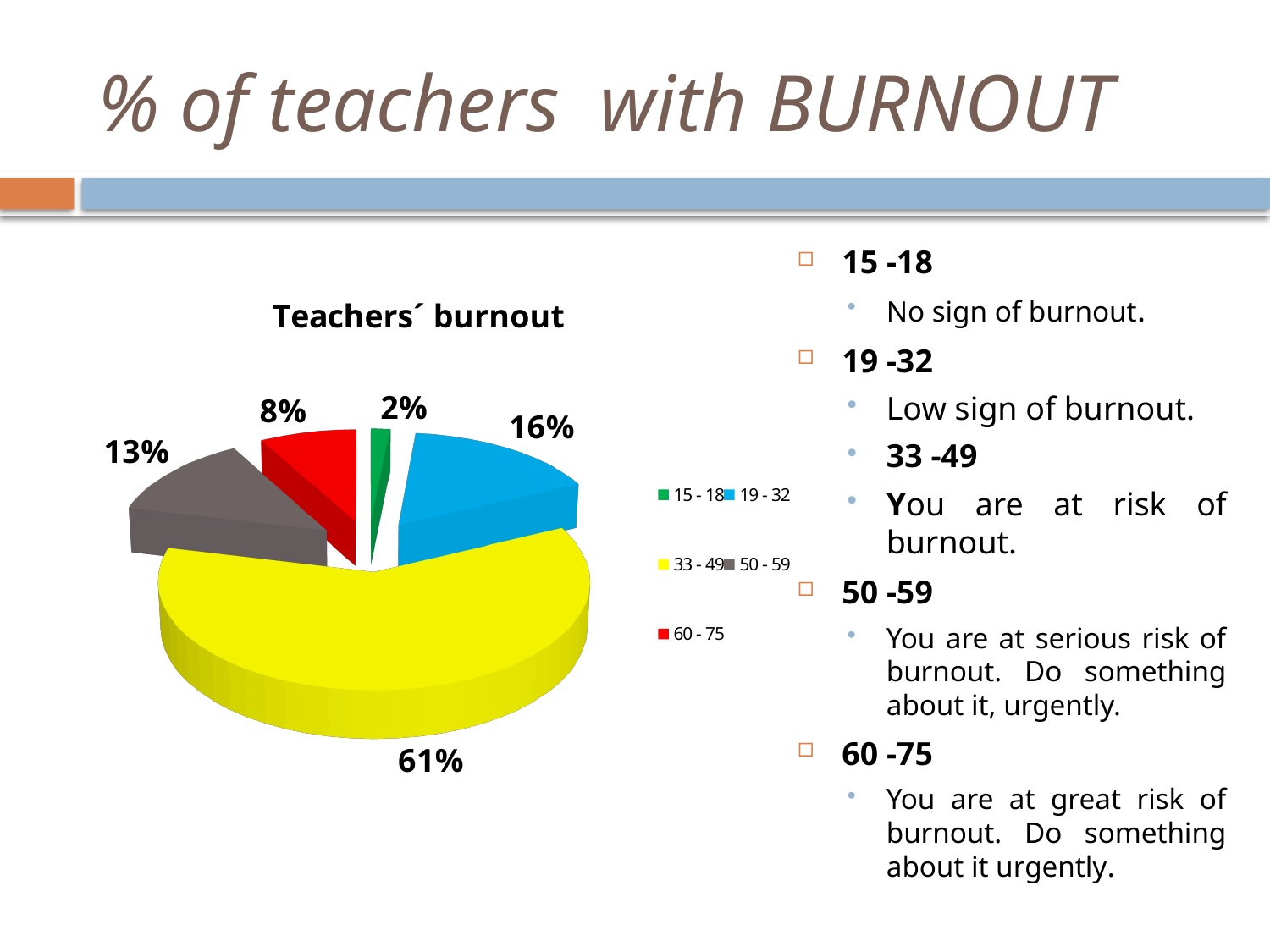
What percentage of teachers fall in the 60 - 75 range? 8% What percentage of teachers fall in the 19 - 32 range? 16% Which is larger, the share for 50 - 59 or the share for 60 - 75? 50 - 59 What percentage of teachers fall in the 15 - 18 range? 2% What percentage of teachers fall in the 33 - 49 range? 61% How many categories does the legend list? 5 What kind of chart is shown on the slide? pie chart What is the difference between the share for 33 - 49 and the share for 19 - 32? 45% What percentage of teachers fall in the 50 - 59 range? 13% Which range has the largest share of the pie? 33 - 49 Which range has the smallest share of the pie? 15 - 18 What is the title of the chart? Teachers´ burnout